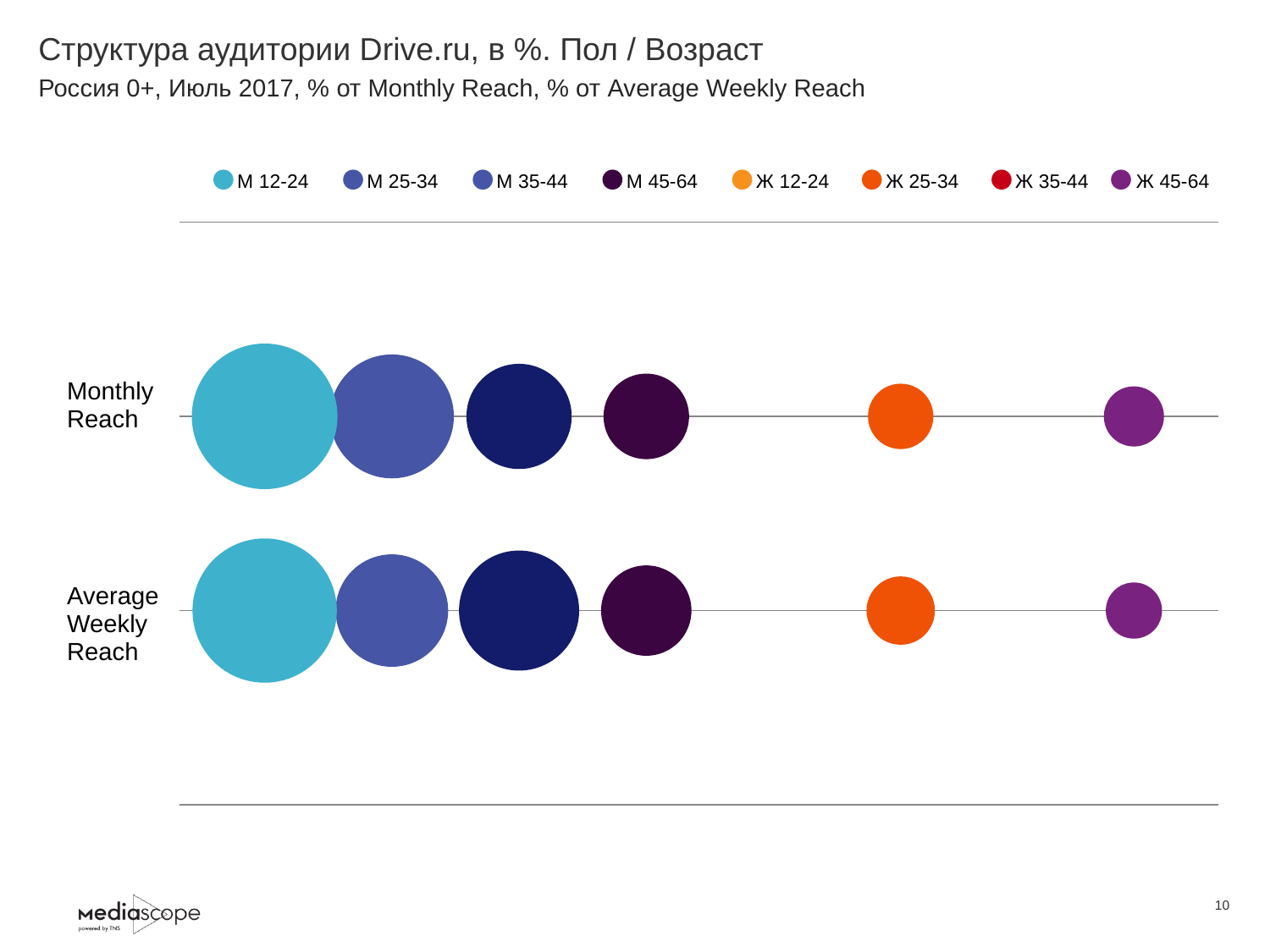
Which series has the largest bubble in the Average Weekly Reach row? М 12-24 Which series has the largest bubble in the Monthly Reach row? М 12-24 What colour is the Ж 25-34 series in the legend? orange In the Monthly Reach row, which bubble is larger: М 12-24 or М 45-64? М 12-24 What are the labels of the two rows on the chart? Monthly Reach and Average Weekly Reach In the Average Weekly Reach row, which bubble is larger: М 35-44 or Ж 45-64? М 35-44 In the Monthly Reach row, which bubble is larger: М 25-34 or Ж 25-34? М 25-34 What kind of chart is shown on the slide? bubble chart How many series does the legend list? 8 How many rows (categories) are plotted on the chart? 2